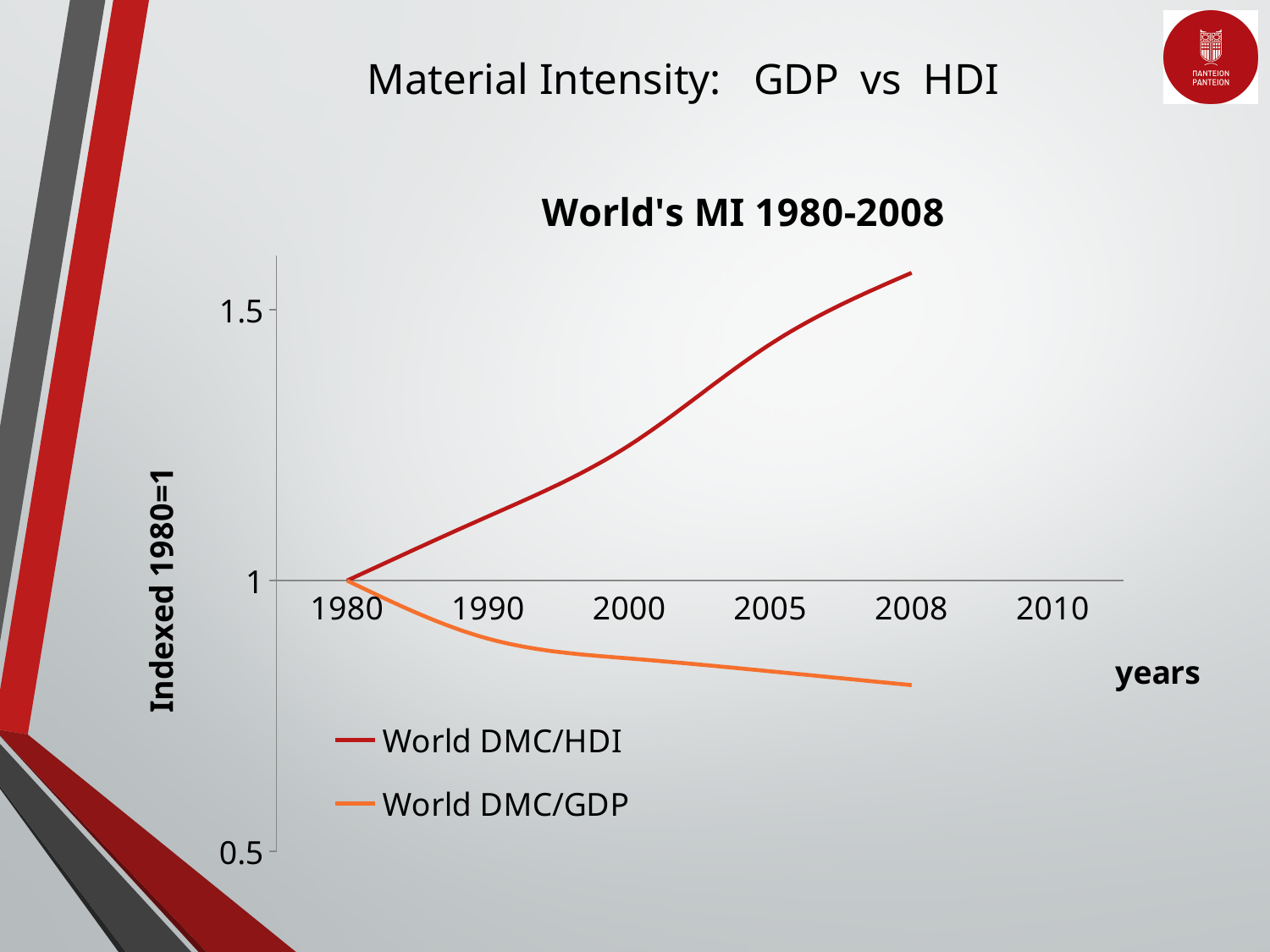
What is the label of the vertical axis? Indexed 1980=1 What is the value of World DMC/GDP in 1980? 1 Is the value for World DMC/HDI in 2000 greater or less than 1? greater Is the value for World DMC/HDI in 2008 greater or less than 1.5? greater What is the value of World DMC/HDI in 1980? 1 Which series has the higher value in 2008, World DMC/HDI or World DMC/GDP? World DMC/HDI What is the title of the chart? World's MI 1980-2008 Is the value for World DMC/GDP in 2008 greater or less than 1? less What kind of chart is shown on the slide? line chart Does the World DMC/GDP series rise or fall from 1980 to 2008? fall How many series does the legend list? 2 Does the World DMC/HDI series rise or fall from 1980 to 2008? rise